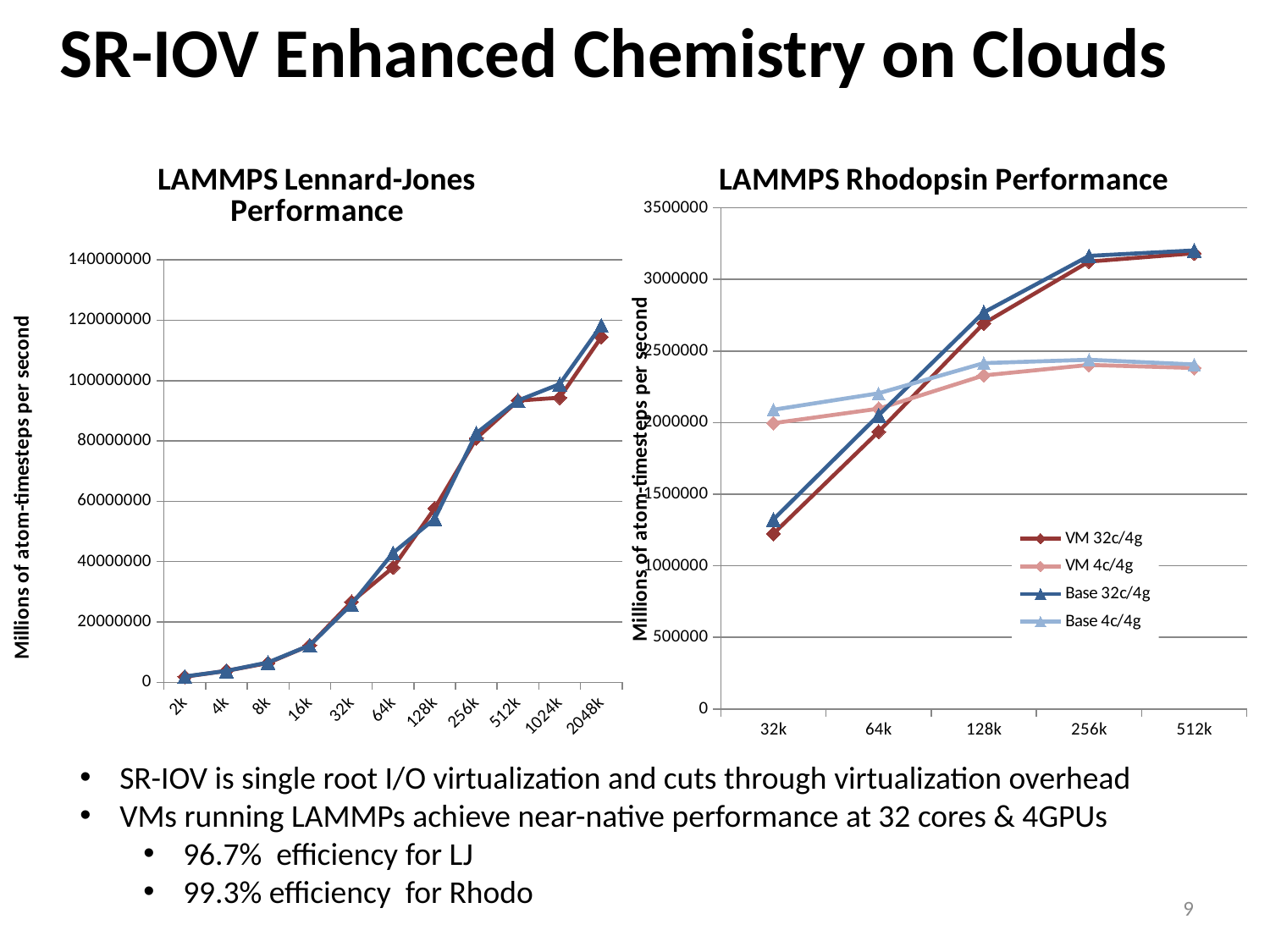
In the LAMMPS Rhodopsin Performance chart, at which category is the Base 32c/4g value lowest? 32k What kind of chart is the LAMMPS Rhodopsin Performance chart? line chart In the LAMMPS Lennard-Jones Performance chart, is the value at 2048k greater or less than 100000000? greater How many series does the legend of the LAMMPS Rhodopsin Performance chart list? 4 In the LAMMPS Lennard-Jones Performance chart, is the value at 256k greater or less than 100000000? less In the LAMMPS Rhodopsin Performance chart, is the value for Base 32c/4g at 512k greater or less than 3000000? greater How many categories are on the x axis of the LAMMPS Rhodopsin Performance chart? 5 In the LAMMPS Lennard-Jones Performance chart, do the values rise or fall as the x axis goes from 2k to 2048k? rise How many categories are on the x axis of the LAMMPS Lennard-Jones Performance chart? 11 What is the y-axis label of the LAMMPS Rhodopsin Performance chart? Millions of atom-timesteps per second In the LAMMPS Rhodopsin Performance chart, which is larger at 512k: Base 32c/4g or Base 4c/4g? Base 32c/4g